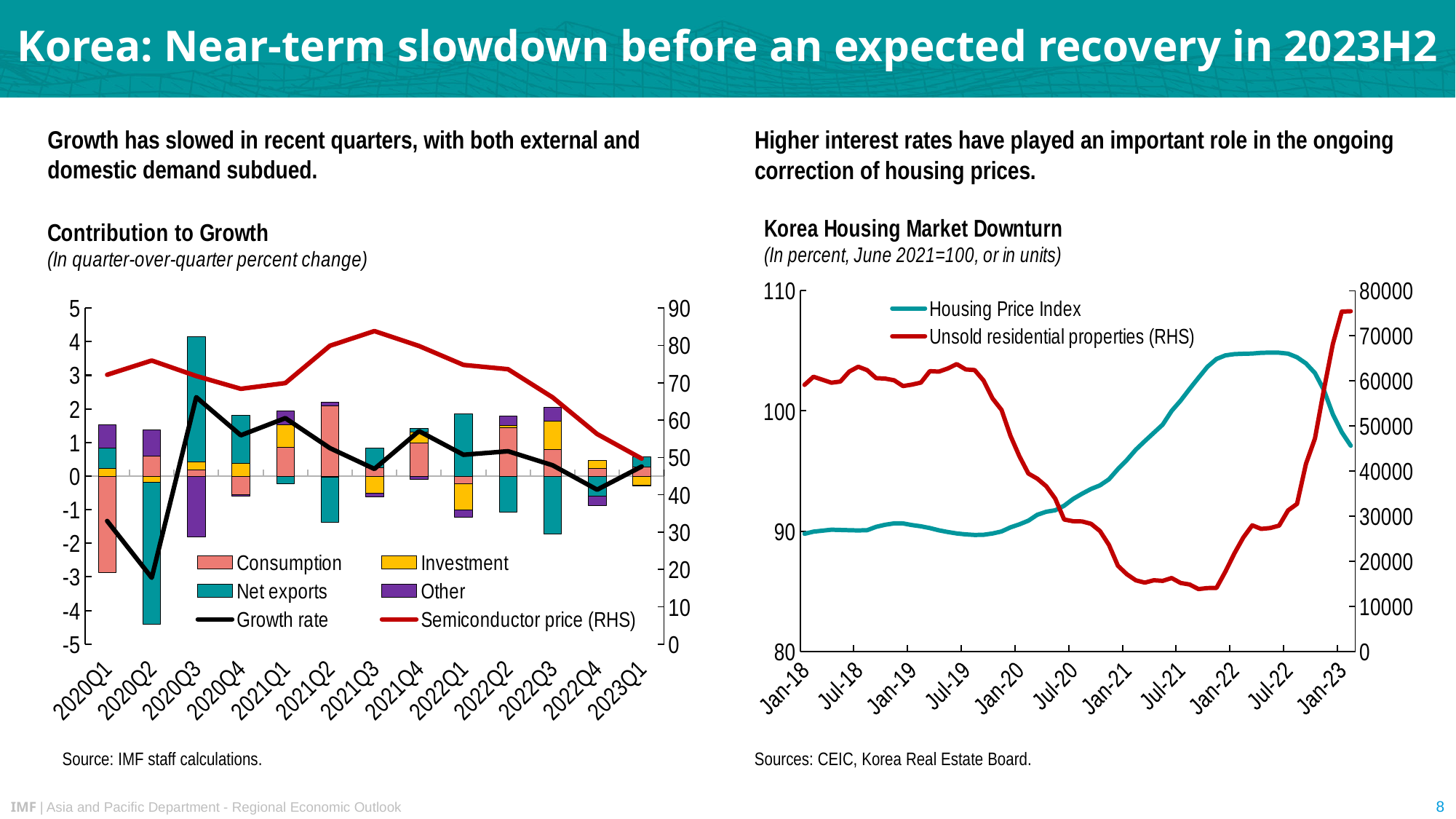
In the Contribution to Growth chart, is the Growth rate for 2020Q2 greater or less than -2? less What kind of chart is the Korea Housing Market Downturn chart? Line chart How many series does the legend of the Contribution to Growth chart list? 6 In the Contribution to Growth chart, how many quarters are shown on the x axis? 13 In the Contribution to Growth chart, in which quarter is the Growth rate line lowest? 2020Q2 In the Contribution to Growth chart, in which quarter does the Semiconductor price (RHS) line reach its highest point? 2021Q3 In the Contribution to Growth chart, is the Semiconductor price (RHS) for 2021Q3 greater or less than 80? greater In the Korea Housing Market Downturn chart, is the value of Unsold residential properties (RHS) at Jan-23 greater or less than 70000? greater How many series does the legend of the Korea Housing Market Downturn chart list? 2 In the Korea Housing Market Downturn chart, does the Housing Price Index rise or fall between Jul-22 and Jan-23? fall In the Contribution to Growth chart, which is larger: the Growth rate in 2020Q3 or in 2020Q2? 2020Q3